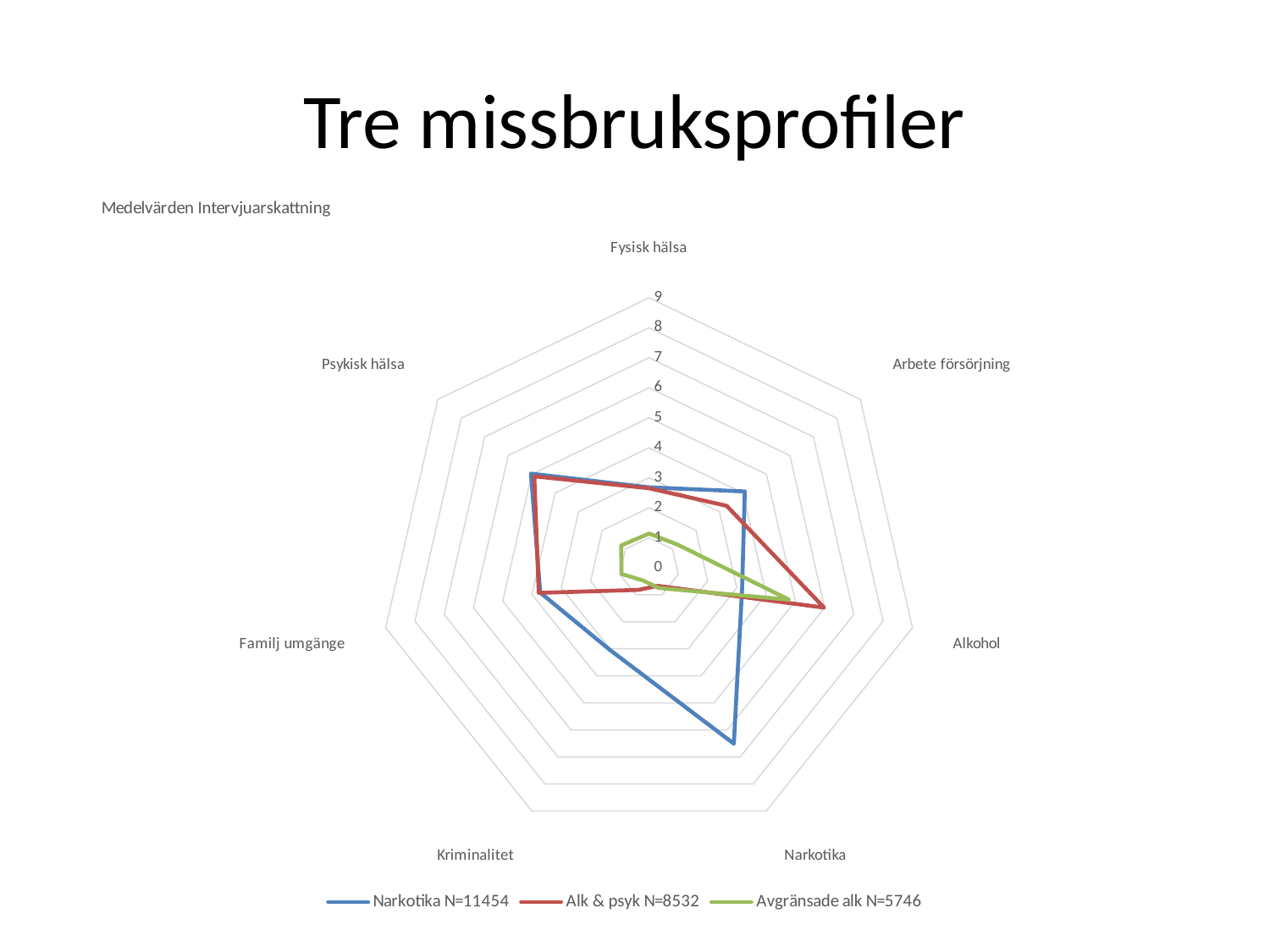
For the Alkohol category, which series has the larger value: Narkotika N=11454 or Alk & psyk N=8532? Alk & psyk N=8532 What is the title of the chart? Medelvärden Intervjuarskattning Is the value of the Alk & psyk N=8532 series for Alkohol greater or less than 4? greater For the Narkotika N=11454 series, which category has the highest value? Narkotika Is the value of the Alk & psyk N=8532 series for Narkotika greater or less than 3? less What kind of chart is shown on the slide? Radar chart Is the value of the Avgränsade alk N=5746 series for Fysisk hälsa greater or less than 3? less For the Narkotika category, which series has the larger value: Narkotika N=11454 or Alk & psyk N=8532? Narkotika N=11454 How many categories (axes) does the radar chart have? 7 How many series does the legend list? 3 Which series is drawn in green in the legend? Avgränsade alk N=5746